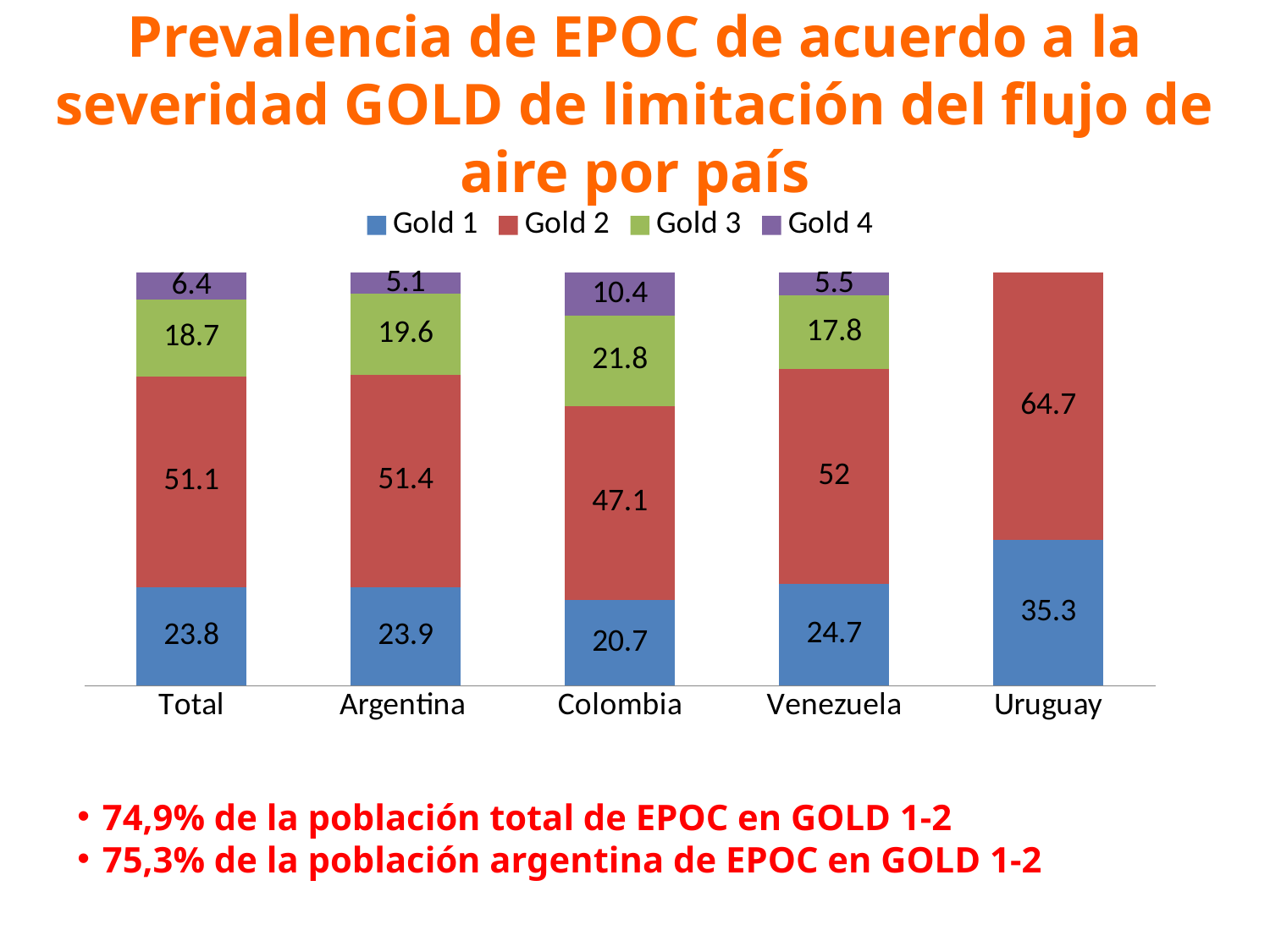
Which category has the lowest Gold 1 value? Colombia What is the total of the stacked bar for Uruguay? 100 How many categories are shown on the x axis? 5 Which country has the highest Gold 1 value? Uruguay Which is larger, the Gold 3 value for Colombia or the Gold 3 value for Venezuela? Colombia What kind of chart is shown on the slide? Stacked bar chart What is the Gold 2 value for Uruguay? 64.7 How many series does the legend list? 4 Which colour represents Gold 3 in the legend? Green What is the difference between the Gold 2 values for Argentina and Colombia? 4.3 What is the Gold 4 value for Colombia? 10.4 What is the Gold 1 value for Venezuela? 24.7